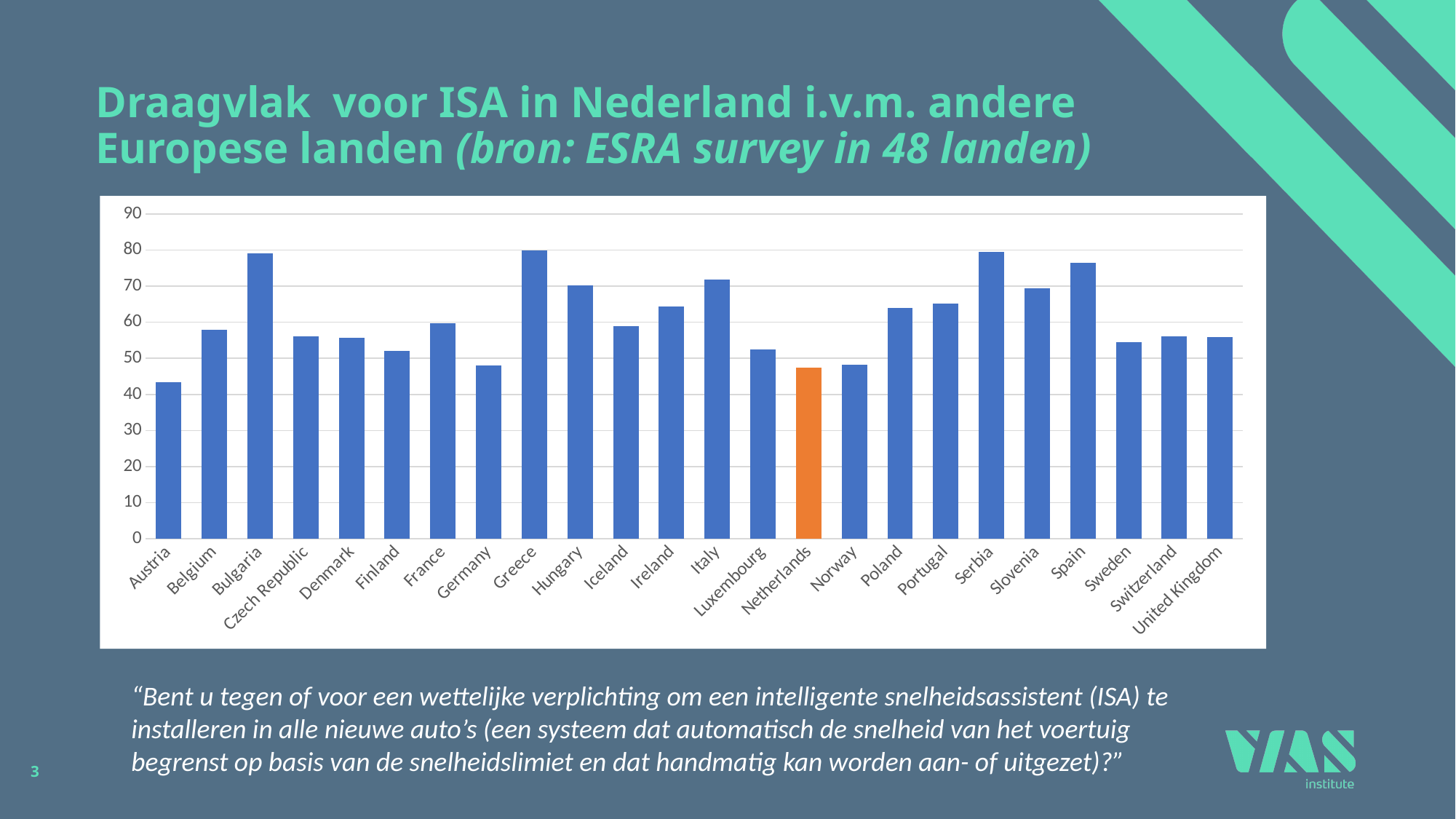
Which country's bar is coloured orange instead of blue? Netherlands Is the value for Greece greater or less than 70? greater According to the slide title, how many countries did the ESRA survey cover? 48 Which has a higher value, Belgium or the Netherlands? Belgium What kind of chart is shown on the slide? bar chart Is the value for Austria greater or less than 50? less How many countries are shown on the x axis of the chart? 24 Is the value for the Netherlands greater or less than 50? less Which country has the lowest value in the chart? Austria Which has a higher value, Spain or Slovenia? Spain